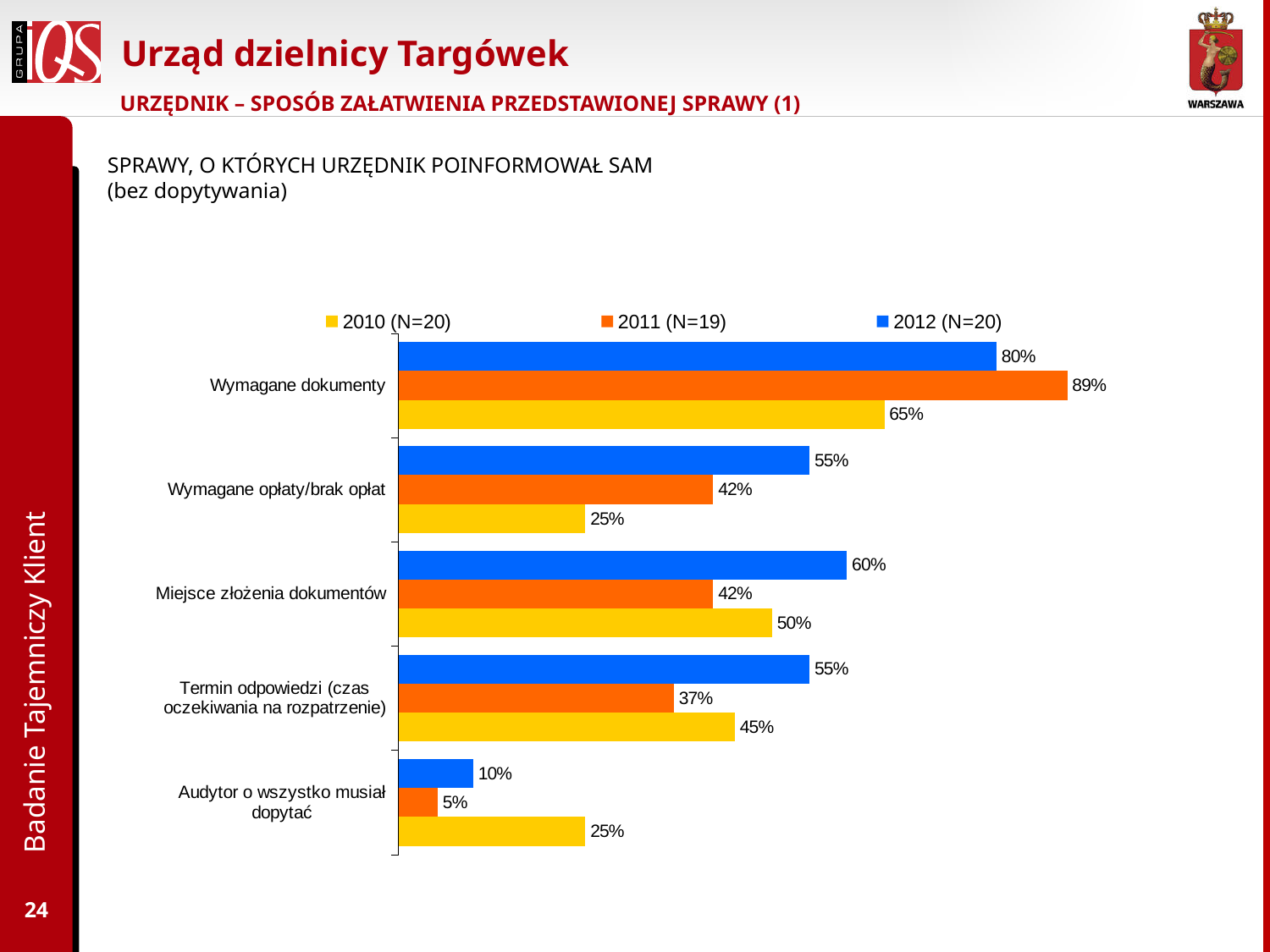
What is the value for Audytor o wszystko musiał dopytać in the 2010 (N=20) series? 25% Which category has the highest value in the 2012 (N=20) series? Wymagane dokumenty What is the value for Miejsce złożenia dokumentów in the 2012 (N=20) series? 60% Which is larger for Termin odpowiedzi (czas oczekiwania na rozpatrzenie): the 2010 (N=20) value or the 2011 (N=19) value? 2010 (N=20) Which colour represents the 2011 (N=19) series? orange Which category has the lowest value in the 2011 (N=19) series? Audytor o wszystko musiał dopytać What is the difference between the 2012 (N=20) and 2010 (N=20) values for Wymagane opłaty/brak opłat? 30% How many categories are shown on the chart? 5 How many series does the legend list? 3 What is the difference between the 2011 (N=19) and 2012 (N=20) values for Wymagane dokumenty? 9% What is the value for Wymagane dokumenty in the 2011 (N=19) series? 89% What kind of chart is shown on the slide? bar chart